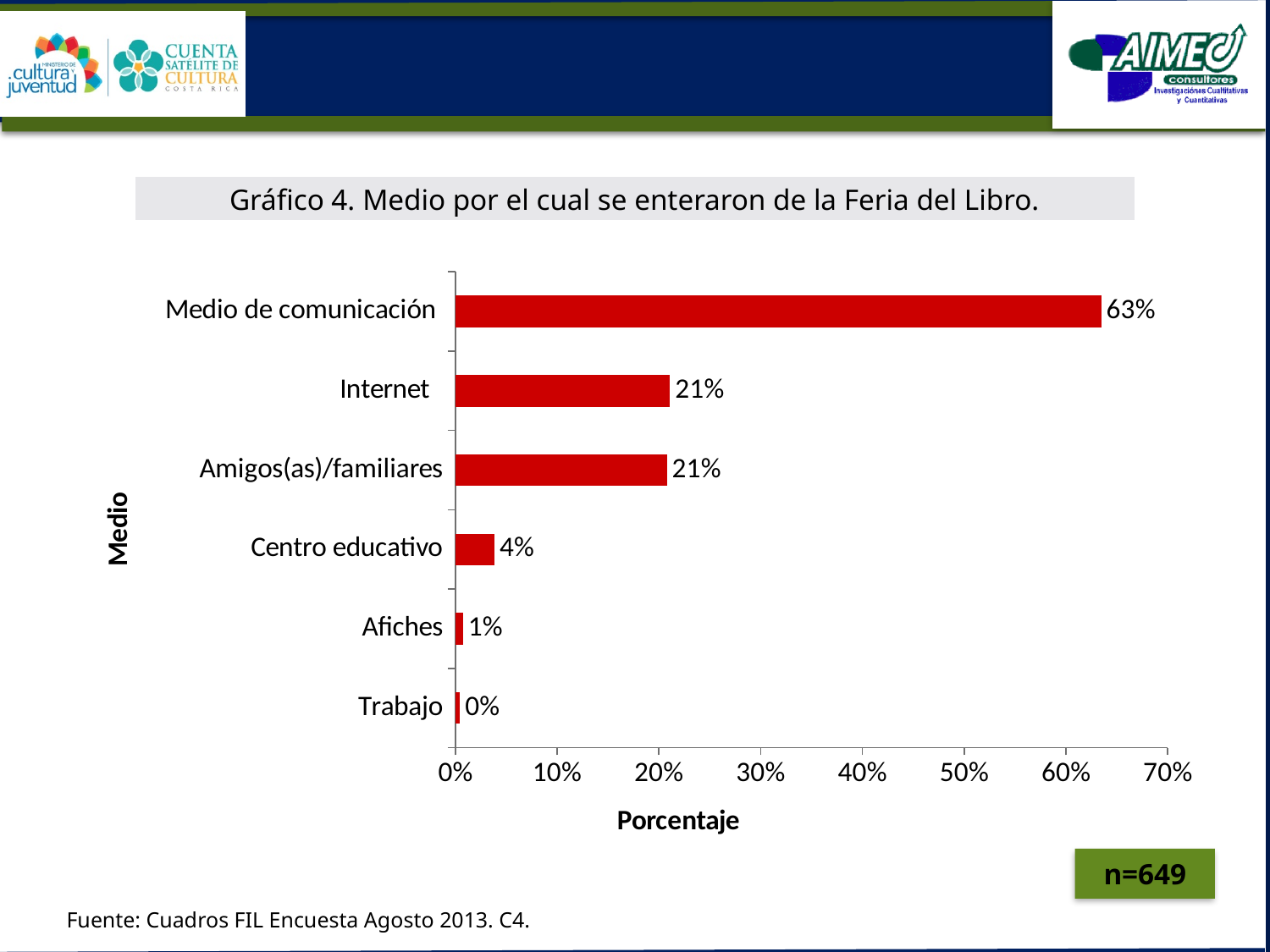
What kind of chart is shown on the slide? Bar chart What is the value shown for Afiches? 1% Which medio has the lowest percentage? Trabajo What percentage of respondents learned about the Feria del Libro through Medio de comunicación? 63% Which is larger, the value for Amigos(as)/familiares or the value for Centro educativo? Amigos(as)/familiares What is the value shown for Centro educativo? 4% What is the value shown for Internet? 21% What is the difference between the values for Centro educativo and Afiches? 3 percentage points What is the difference between the values for Medio de comunicación and Internet? 42 percentage points What is the label of the horizontal axis? Porcentaje Which medio has the highest percentage? Medio de comunicación How many categories (medios) are shown in the chart? 6